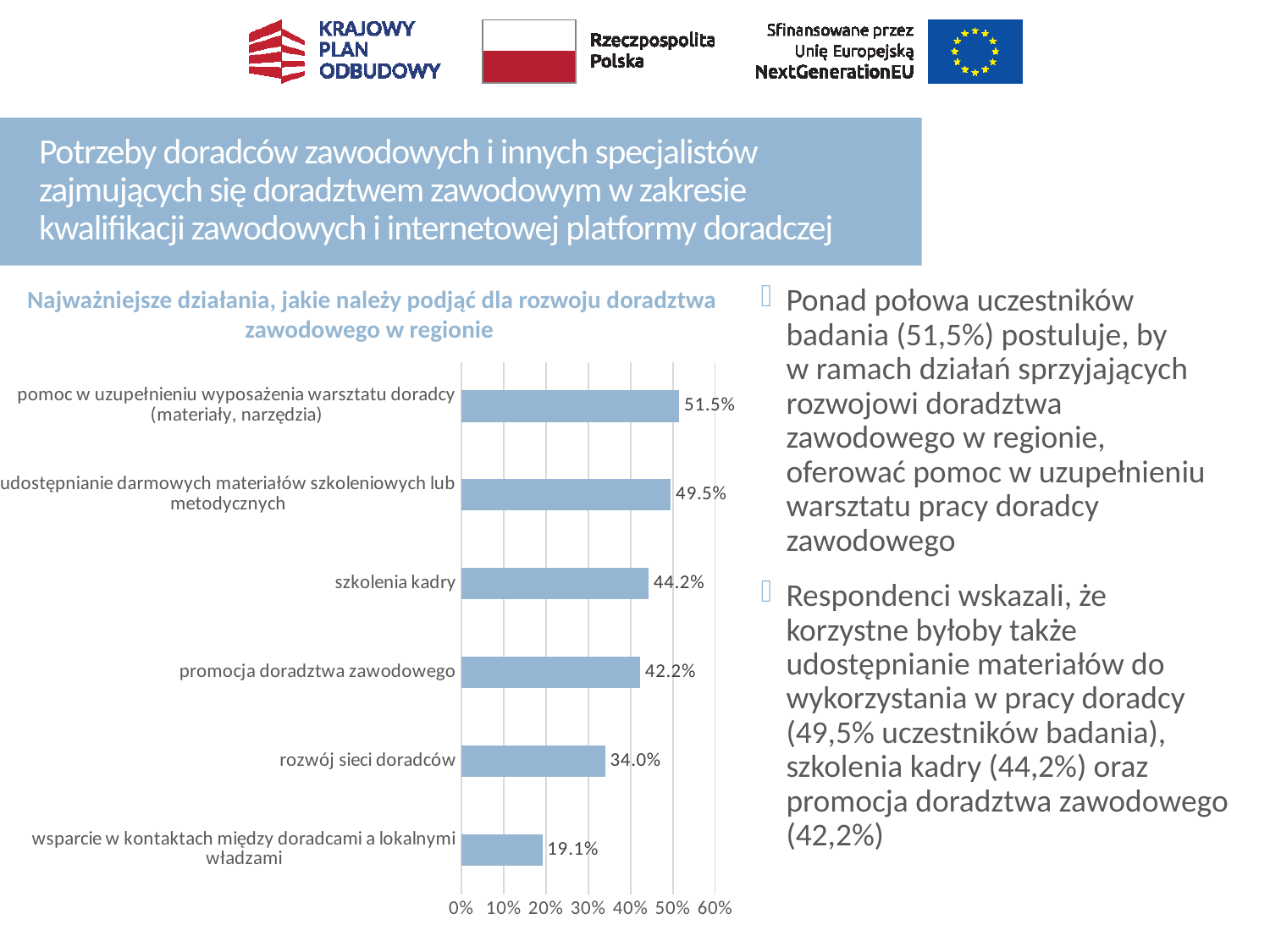
What is the title of the chart? Najważniejsze działania, jakie należy podjąć dla rozwoju doradztwa zawodowego w regionie What is the difference between the values for "pomoc w uzupełnieniu wyposażenia warsztatu doradcy (materiały, narzędzia)" and "udostępnianie darmowych materiałów szkoleniowych lub metodycznych"? 2.0% Which category has the highest value? pomoc w uzupełnieniu wyposażenia warsztatu doradcy (materiały, narzędzia) What kind of chart is shown on the slide? bar chart What is the value for "szkolenia kadry"? 44.2% What is the value for "rozwój sieci doradców"? 34.0% Is the value for "rozwój sieci doradców" greater or less than 40%? less Which is larger: the value for "szkolenia kadry" or the value for "promocja doradztwa zawodowego"? szkolenia kadry How many categories are shown in the chart? 6 What is the value for "wsparcie w kontaktach między doradcami a lokalnymi władzami"? 19.1% Which category has the lowest value? wsparcie w kontaktach między doradcami a lokalnymi władzami What is the difference between the values for "promocja doradztwa zawodowego" and "rozwój sieci doradców"? 8.2%